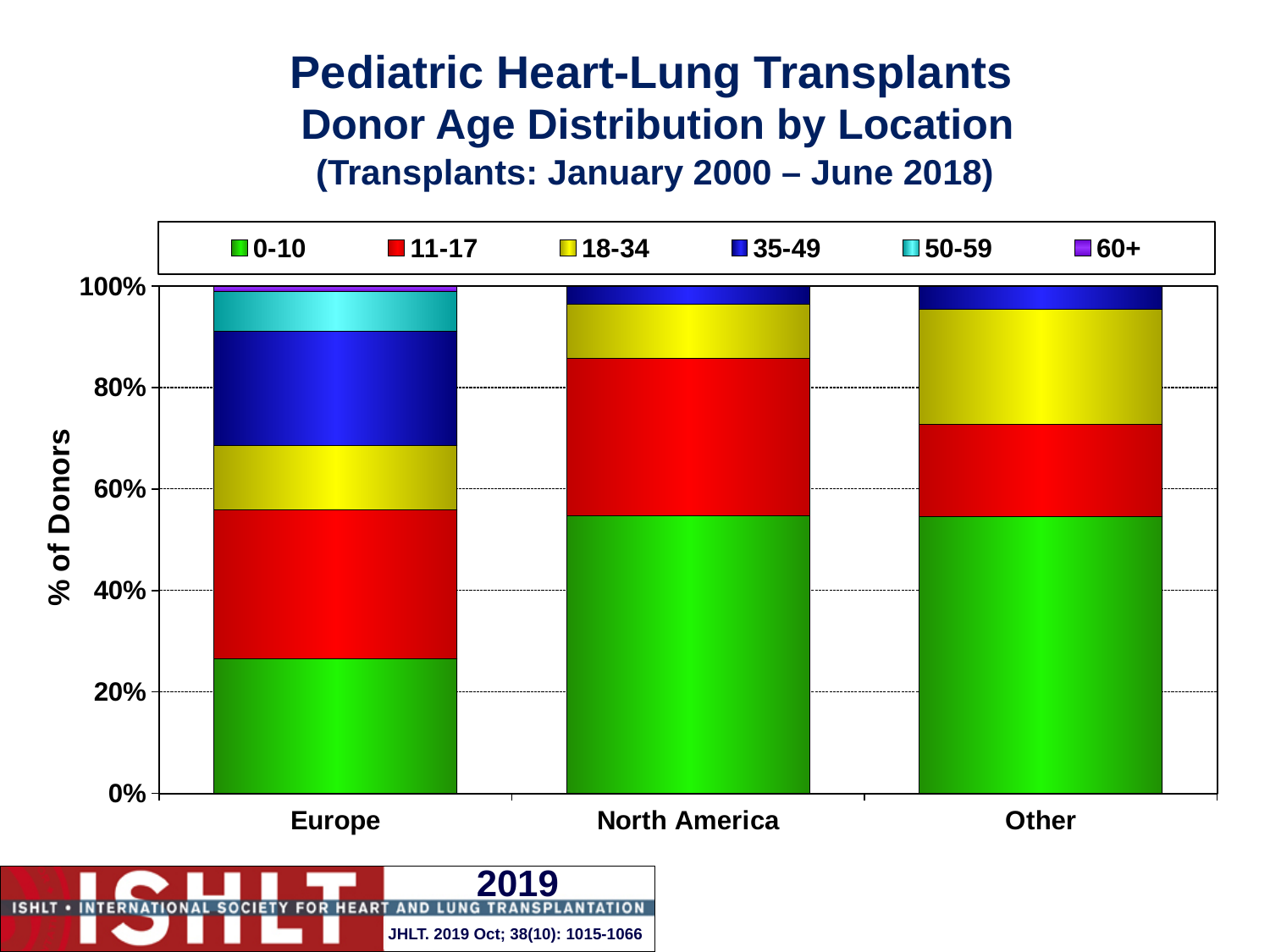
How many locations are shown along the x axis? 3 How many donor age groups does the legend list? 6 What kind of chart is shown on the slide? Stacked bar chart What is the label on the y axis? % of Donors Which location has the largest share of donors aged 35-49? Europe Which is larger: the share of donors aged 18-34 in North America or in Other? Other Is the share of donors aged 0-10 in Europe greater or less than 40%? less Which location has the smallest share of donors aged 0-10? Europe Is the share of donors aged 0-10 in North America greater or less than 40%? greater Which is larger: the share of donors aged 0-10 in Europe or in North America? North America Is the share of donors aged 0-10 in Other greater or less than 60%? less Which location is the only one with a 50-59 donor age segment visible in its bar? Europe